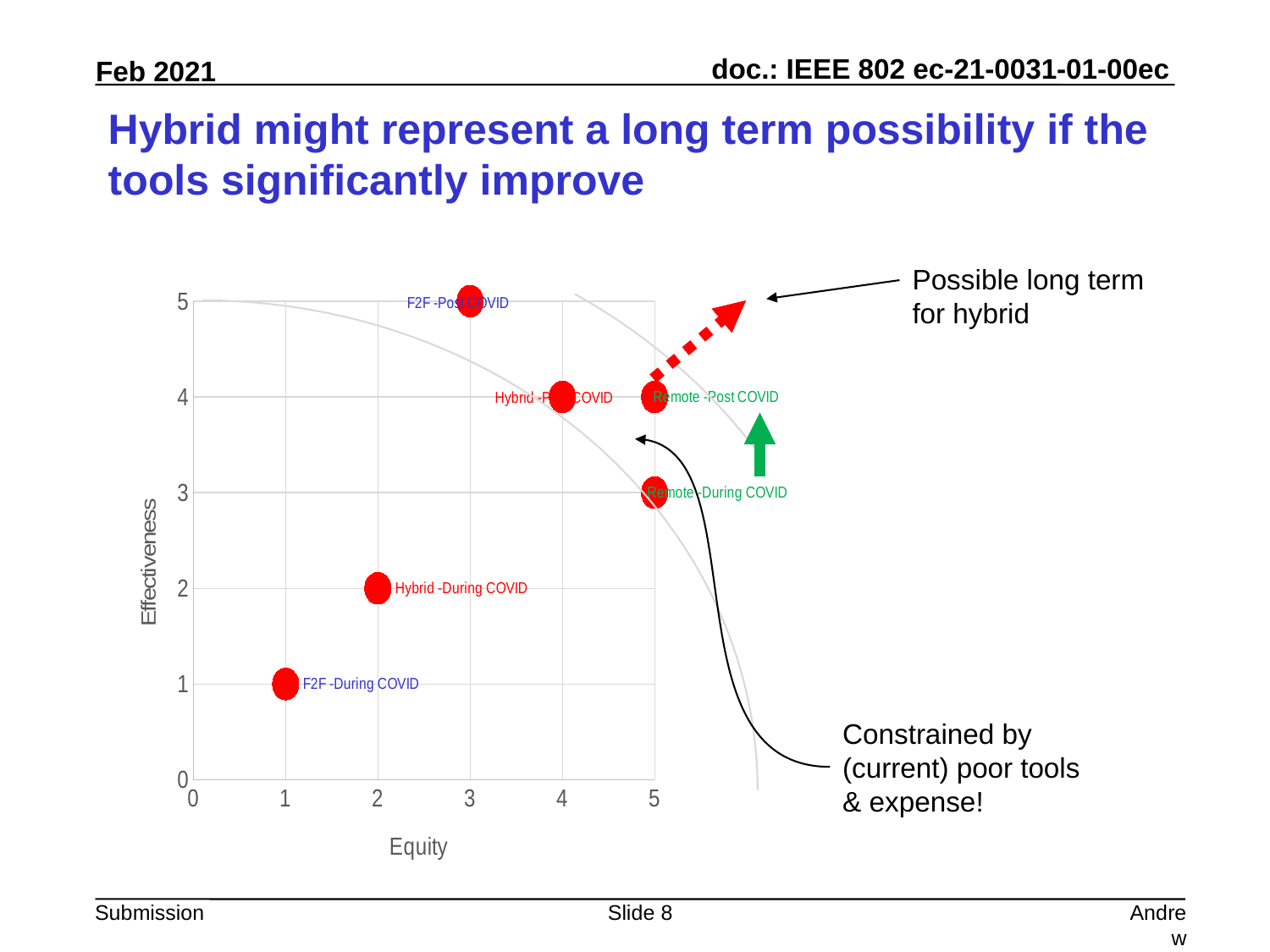
What is the label of the horizontal axis of the chart? Equity What is the Equity value for F2F -Post COVID? 3 What is the difference in Effectiveness between Hybrid -Post COVID and Hybrid -During COVID? 2 What is the Effectiveness value for F2F -During COVID? 1 What is the Effectiveness value for Remote -During COVID? 3 Which point has the lowest Equity value? F2F -During COVID How many data points are plotted on the chart? 6 What is the Equity value for Hybrid -During COVID? 2 What is the label of the vertical axis of the chart? Effectiveness Which has the higher Equity value, Remote -Post COVID or Hybrid -Post COVID? Remote -Post COVID Which point has the highest Effectiveness value? F2F -Post COVID What kind of chart is shown on the slide? Scatter chart